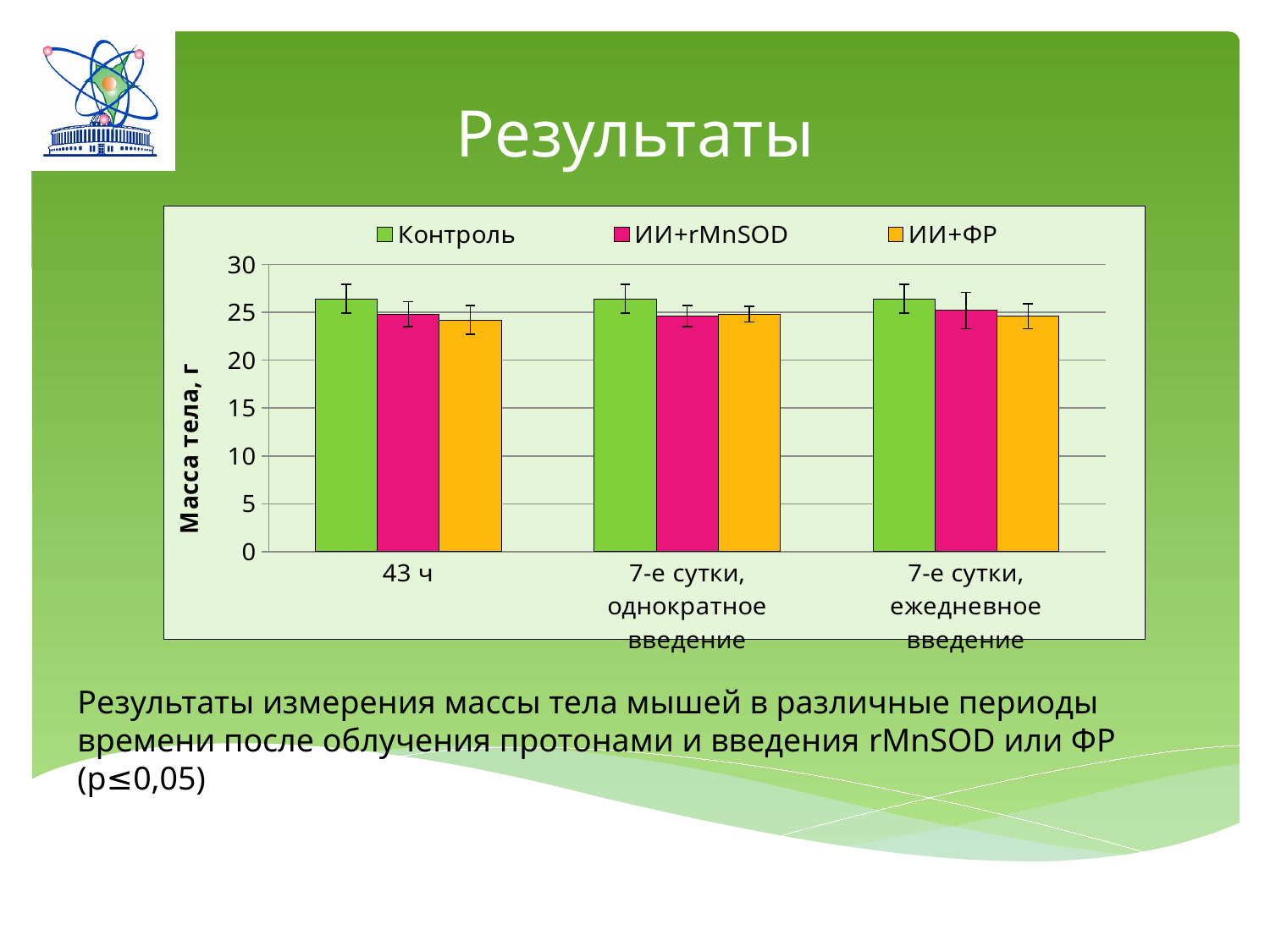
In the 7-е сутки, однократное введение category, which is larger: the value for Контроль or the value for ИИ+rMnSOD? Контроль Is the value for ИИ+ФР at 43 ч greater or less than 25? less Is the value for Контроль at 7-е сутки, ежедневное введение greater or less than 25? greater In the 43 ч category, which is larger: the value for Контроль or the value for ИИ+ФР? Контроль Is the value for Контроль at 43 ч greater or less than 25? greater What kind of chart is shown on the slide? bar chart What is the label of the y axis of the chart? Масса тела, г Which series has the highest value in the 43 ч category? Контроль How many categories are shown along the x axis of the chart? 3 Which series is shown in green in the chart? Контроль How many series does the chart legend list? 3